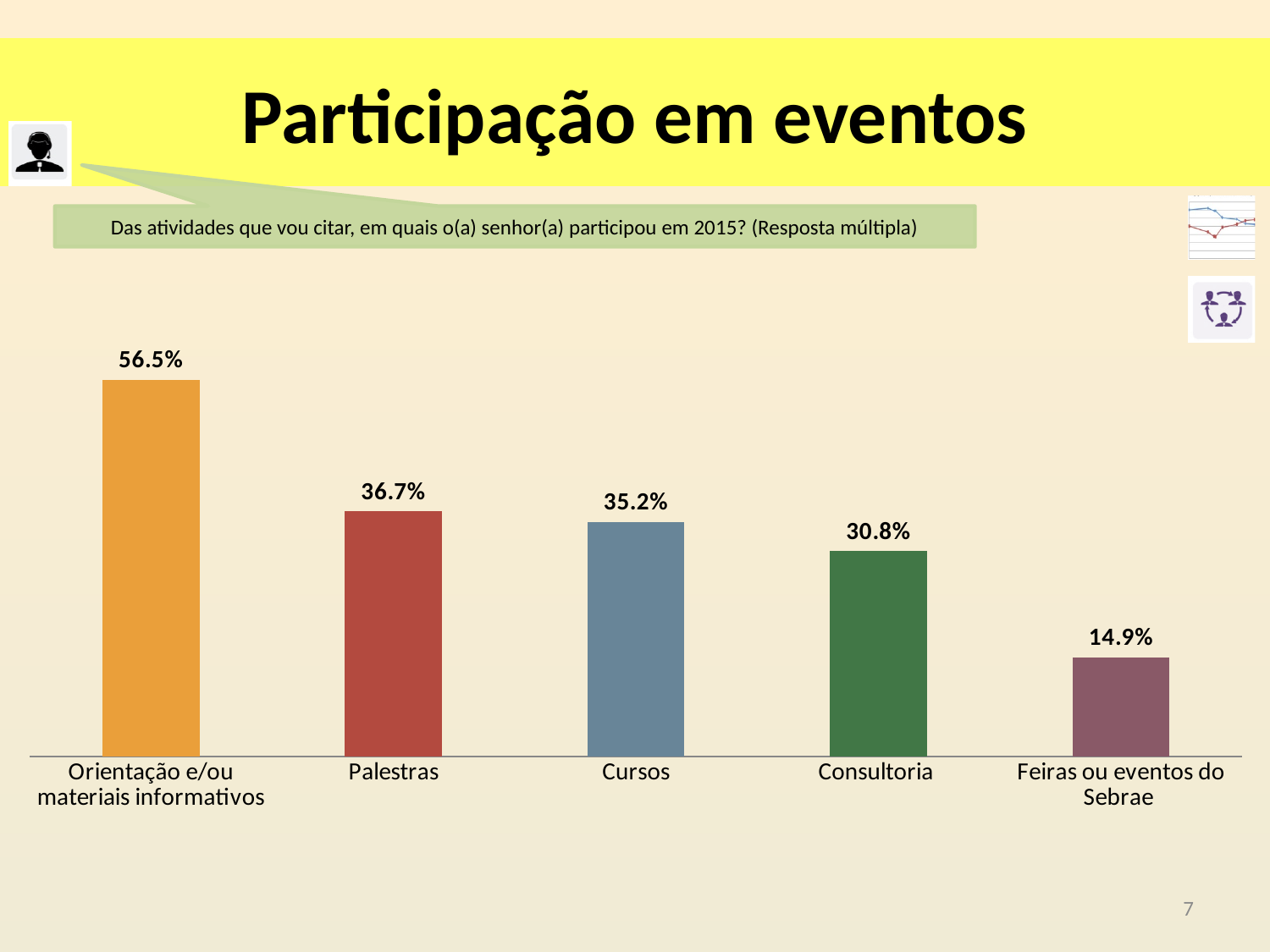
What is the value for Cursos? 35.2% What is the value for Palestras? 36.7% Which category has the lowest value? Feiras ou eventos do Sebrae Which is larger, the value for Cursos or the value for Consultoria? Cursos How many categories are shown in the chart? 5 Do the values rise or fall from left to right along the x axis? Fall What kind of chart is shown on the slide? Bar chart What is the difference between the values for Orientação e/ou materiais informativos and Palestras? 19.8% What is the difference between the values for Consultoria and Feiras ou eventos do Sebrae? 15.9% Which category has the highest value? Orientação e/ou materiais informativos What is the value for Consultoria? 30.8% What is the value for Feiras ou eventos do Sebrae? 14.9%